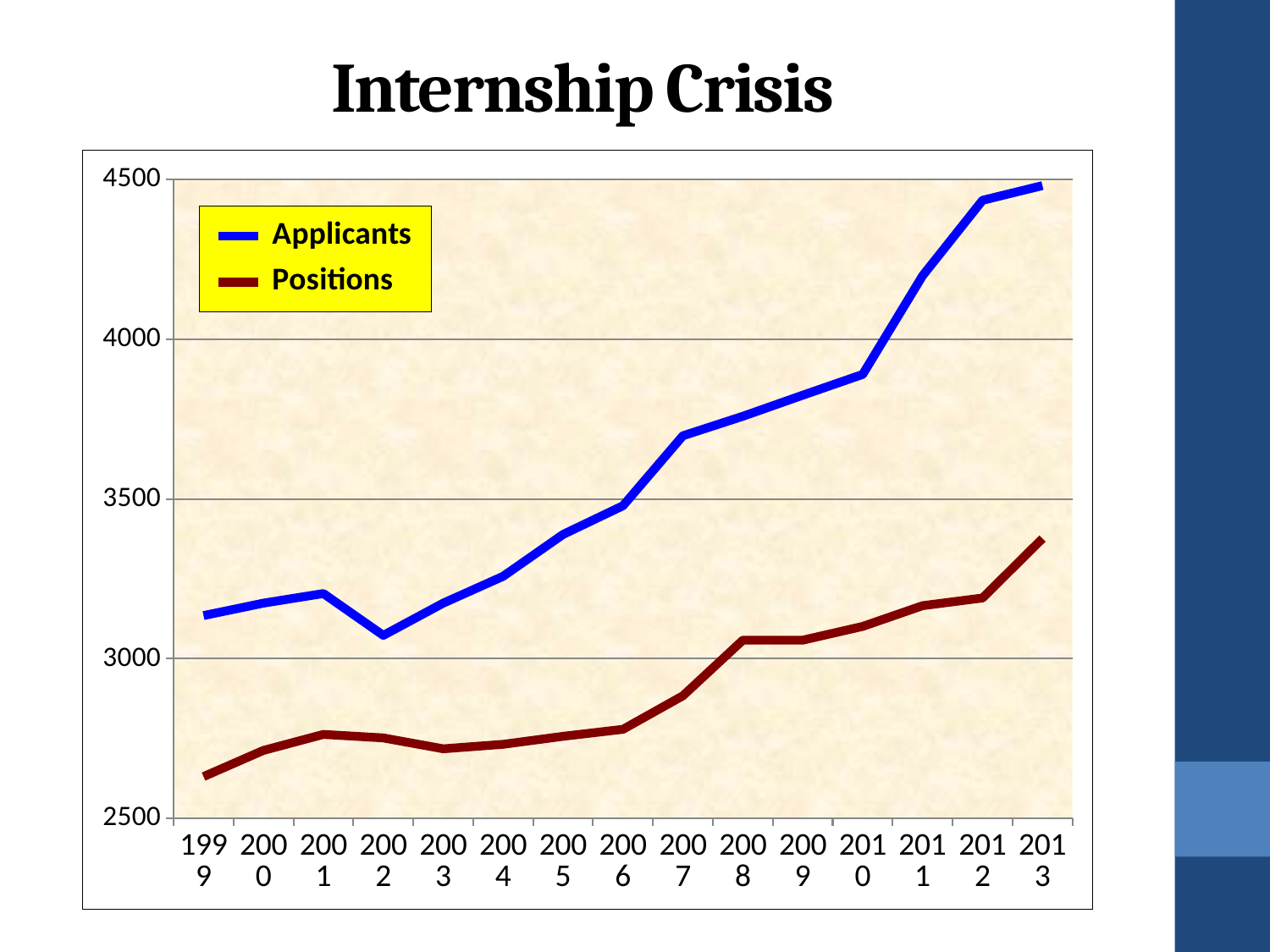
How many series does the legend list? 2 Is the value for Positions in 2013 greater or less than 3000? greater Is the value for Applicants in 2002 greater or less than 3500? less Is the value for Applicants in 2007 greater or less than 3500? greater What kind of chart is shown on the slide? line chart In which year is the Positions series at its lowest? 1999 How many years are plotted along the x axis? 15 In 2013, which series has the larger value, Applicants or Positions? Applicants In which year is the Applicants series at its highest? 2013 What is the title of the chart? Internship Crisis